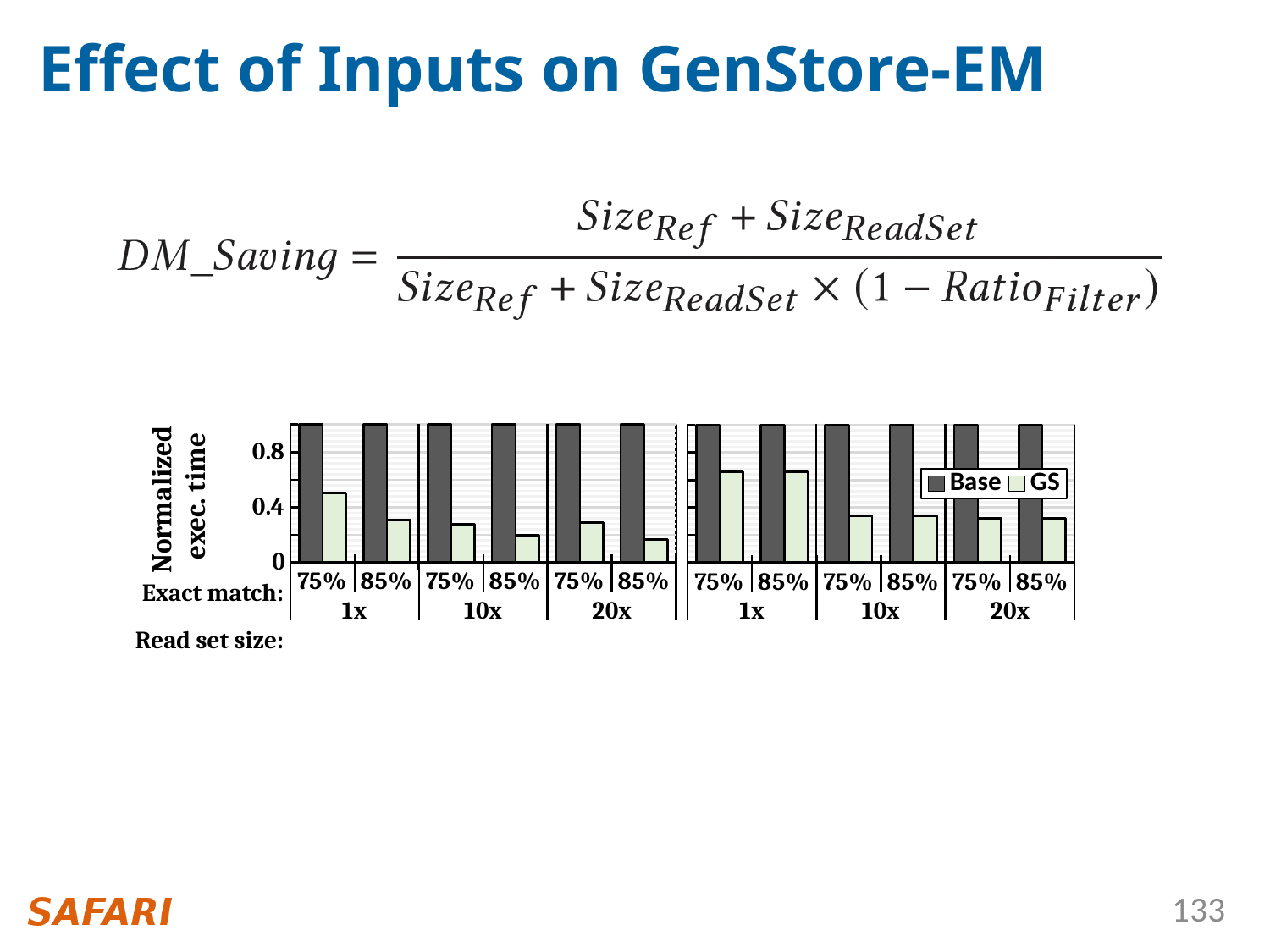
In the left panel of the chart, is the GS value for read set size 1x with 85% exact match greater or less than 0.4? less In the left panel of the chart, do the GS values for 75% exact match rise or fall as the read set size increases from 1x to 10x? fall What is the y-axis label of the chart? Normalized exec. time In the right panel of the chart, is the GS value for read set size 1x with 75% exact match greater or less than 0.4? greater In the left panel of the chart, which is larger for read set size 1x: the GS value at 75% exact match or at 85% exact match? 75% What kind of chart is shown on the slide? bar chart Which read set sizes are shown along the x axis of the chart? 1x, 10x, 20x In the left panel of the chart, is the GS value for read set size 1x with 75% exact match greater or less than 0.4? greater In the left panel of the chart, which read set size and exact match combination has the highest GS value? 1x, 75% What are the two series named in the chart legend? Base and GS How many series does the chart legend list? 2